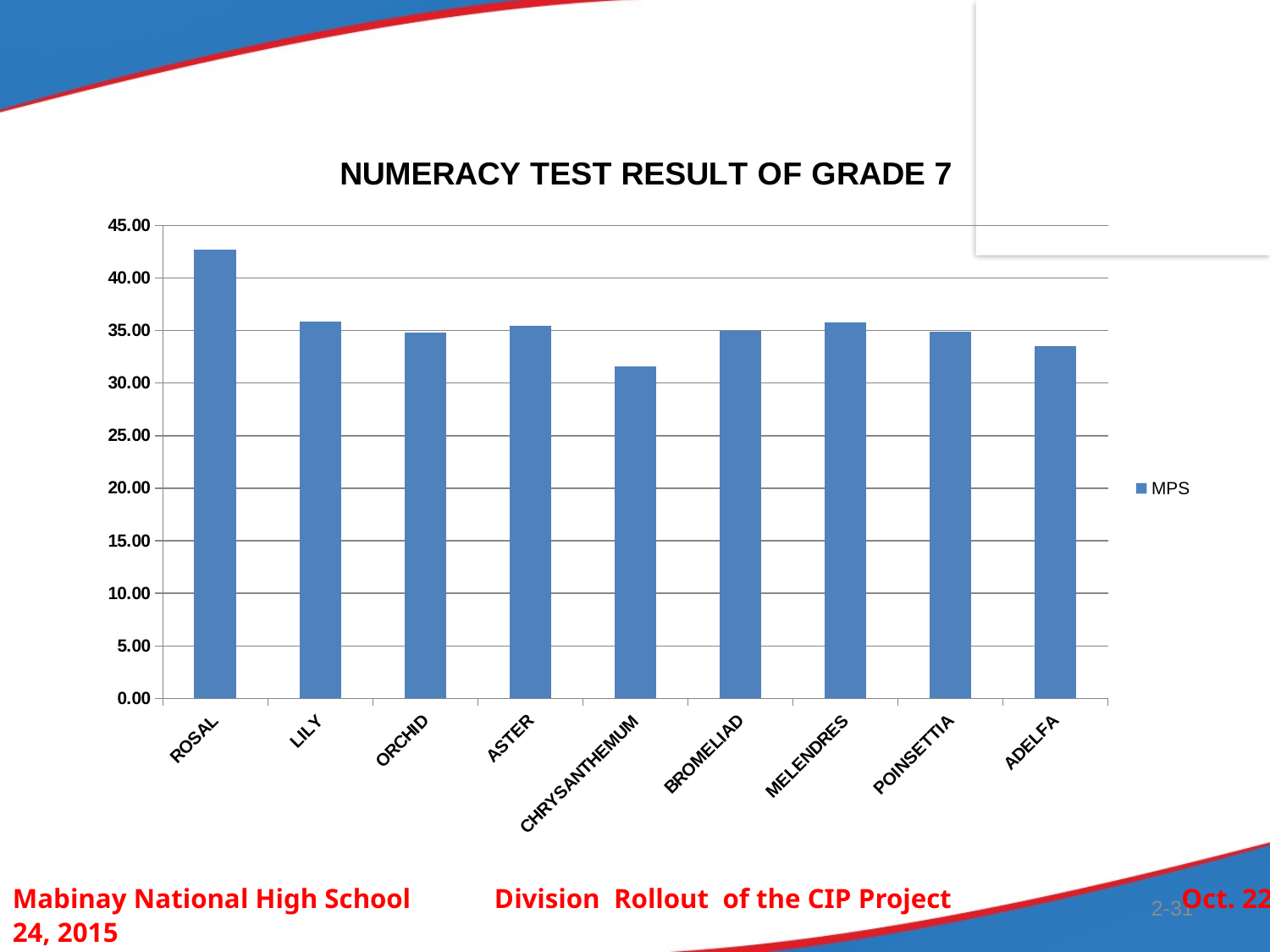
What series name is shown in the legend? MPS Which has a higher MPS, ADELFA or CHRYSANTHEMUM? ADELFA Which section has the lowest MPS? CHRYSANTHEMUM Is the MPS for ADELFA greater or less than 35.00? less How many sections (categories) are shown on the x axis of the chart? 9 How many series does the legend list? 1 Is the MPS for CHRYSANTHEMUM greater or less than 35.00? less Which has a higher MPS, ROSAL or LILY? ROSAL Which section has the highest MPS? ROSAL What kind of chart is shown on the slide? bar chart Is the MPS for ROSAL greater or less than 40.00? greater What is the title of the chart? NUMERACY TEST RESULT OF GRADE 7